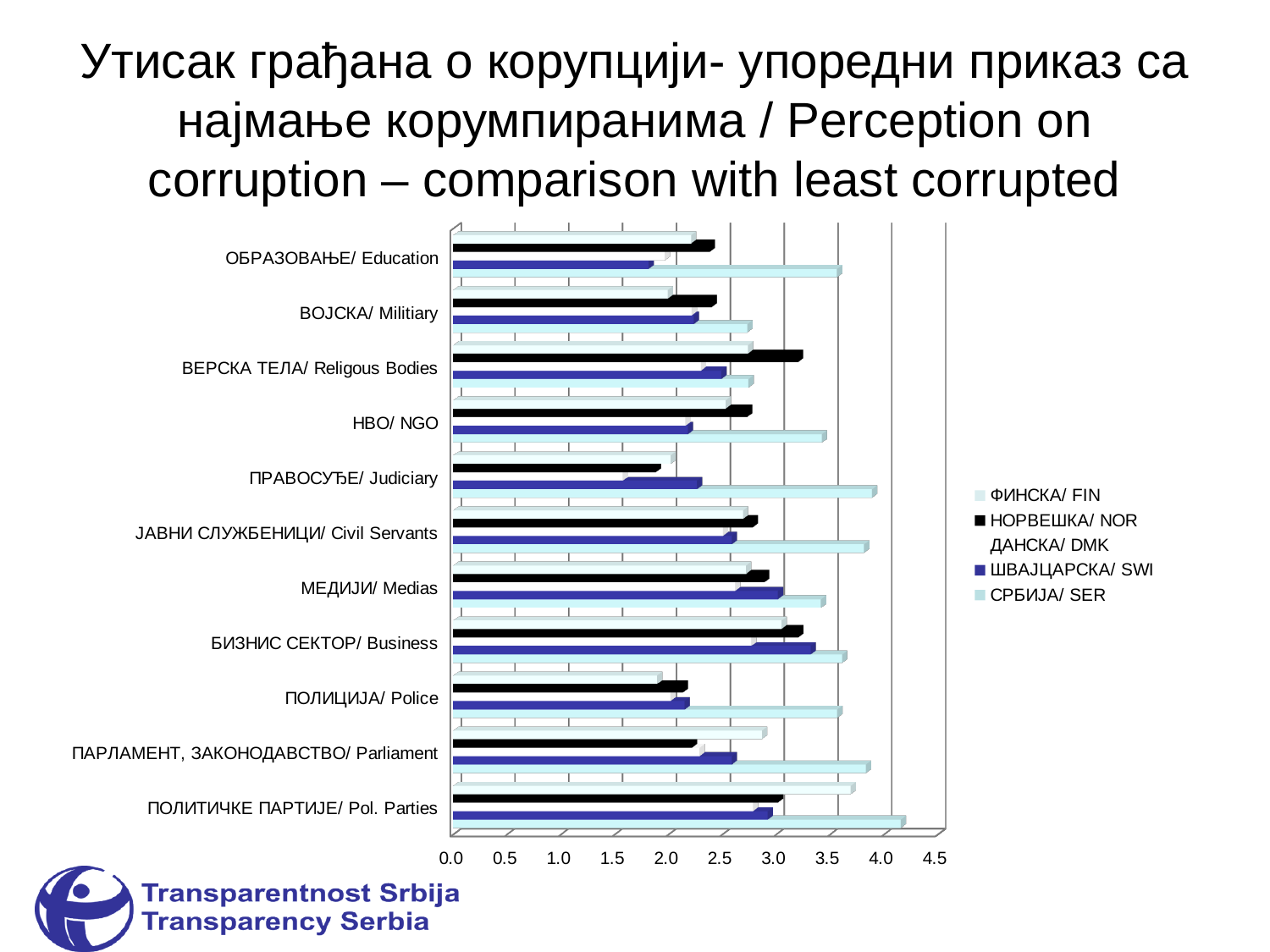
Is the value for СРБИЈА/ SER in the ПОЛИТИЧКЕ ПАРТИЈЕ/ Pol. Parties category greater or less than 4.0? greater For which category is the СРБИЈА/ SER value the highest? ПОЛИТИЧКЕ ПАРТИЈЕ/ Pol. Parties How many categories (sectors) are listed on the vertical axis of the chart? 11 Is the value for НОРВЕШКА/ NOR in the ПРАВОСУЂЕ/ Judiciary category greater or less than 2.0? less Is the value for СРБИЈА/ SER in the ПОЛИЦИЈА/ Police category greater or less than 3.0? greater Which series is shown in black in the chart legend? НОРВЕШКА/ NOR In the ОБРАЗОВАЊЕ/ Education category, which is larger: the value for СРБИЈА/ SER or for ШВАЈЦАРСКА/ SWI? СРБИЈА/ SER How many series does the chart legend list? 5 In the ВЕРСКА ТЕЛА/ Religous Bodies category, which is larger: the value for НОРВЕШКА/ NOR or for ШВАЈЦАРСКА/ SWI? НОРВЕШКА/ NOR What kind of chart is shown on the slide? bar chart